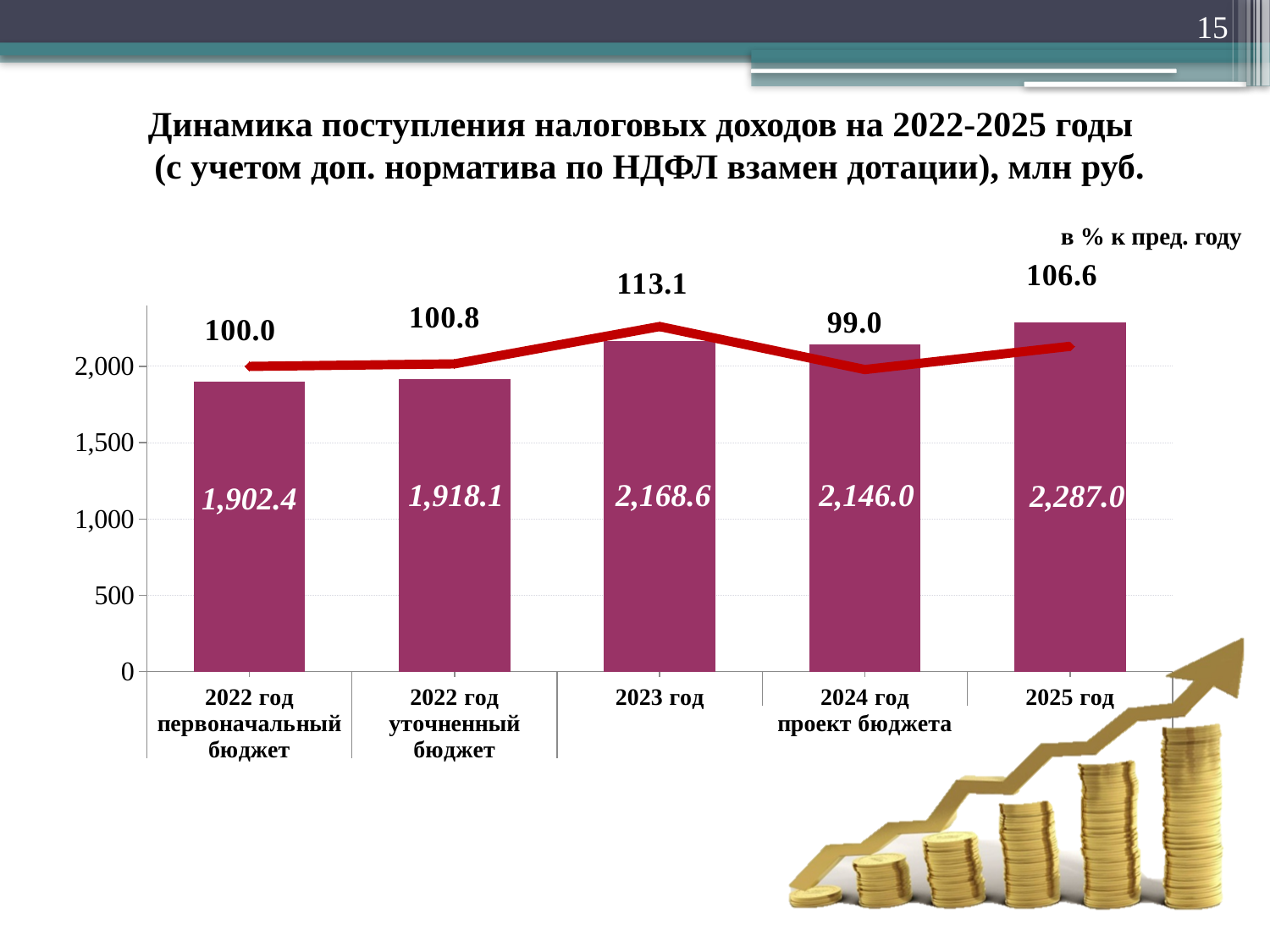
Which is larger, the bar value for 2023 год or for 2024 год проект бюджета? 2023 год What kind of chart is shown on the slide? Bar chart with a line What percentage to the previous year (в % к пред. году) is shown for 2024 год проект бюджета? 99.0 What percentage to the previous year is shown for 2025 год? 106.6 What is the difference between the bar values for 2025 год and 2024 год проект бюджета? 141.0 Which category has the lowest bar value? 2022 год первоначальный бюджет What is the value of the bar for 2023 год? 2,168.6 What is the title of the chart? Динамика поступления налоговых доходов на 2022-2025 годы (с учетом доп. норматива по НДФЛ взамен дотации), млн руб. How many categories are shown on the x axis? 5 Is the bar value for 2022 год уточненный бюджет greater or less than 2,000? less Which category has the highest bar value? 2025 год What is the value of the bar for 2022 год первоначальный бюджет? 1,902.4